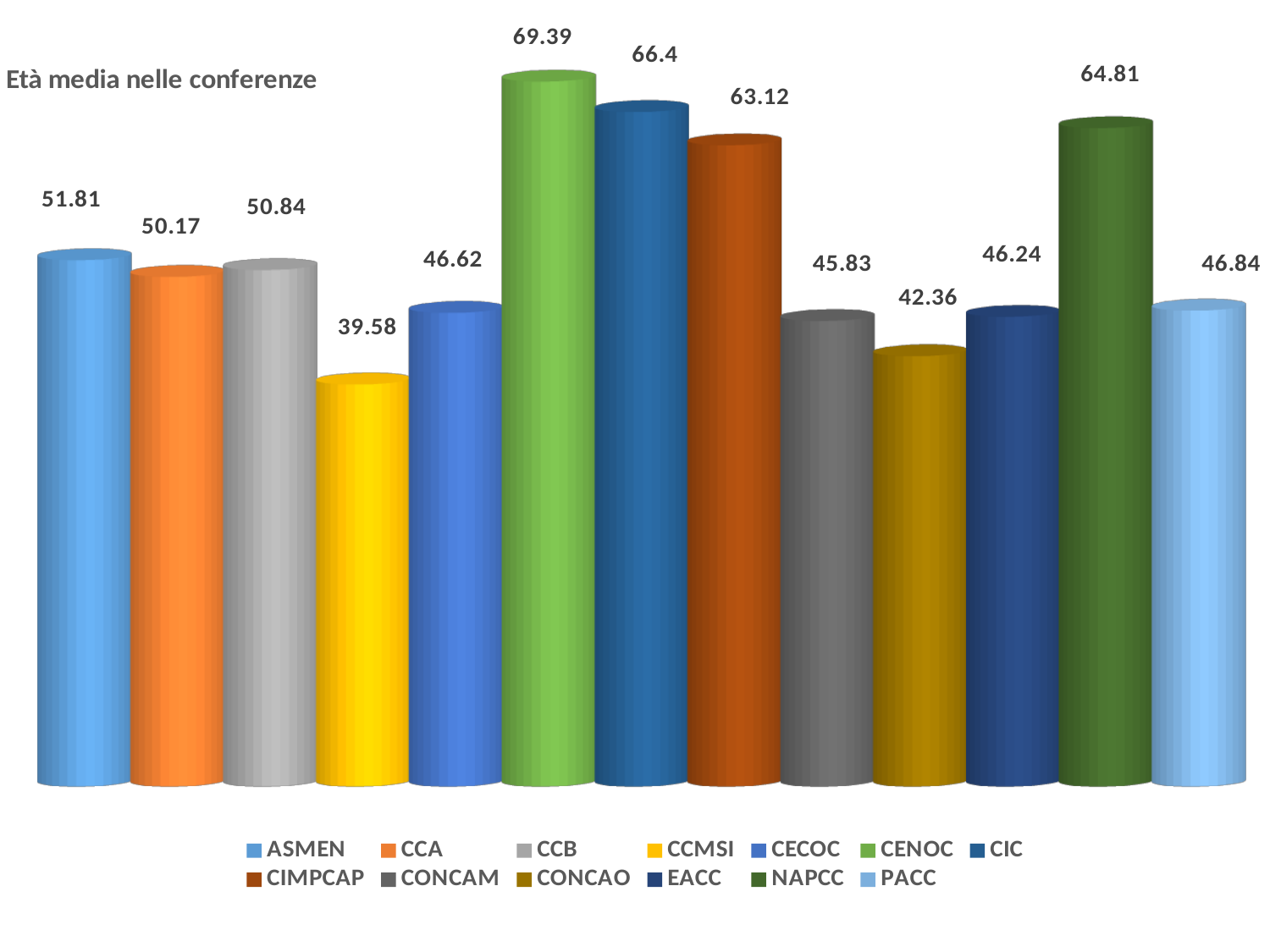
What is the difference between the values for CIC and CIMPCAP? 3.28 Which category has the lowest value? CCMSI What kind of chart is shown on the slide? Bar chart What is the value for CCMSI? 39.58 Which is larger, the value for CONCAO or the value for PACC? PACC What is the value for NAPCC? 64.81 Which category has the highest value? CENOC What is the value for CENOC? 69.39 How many entries does the legend list? 13 What is the title of the chart? Età media nelle conferenze How many categories are plotted in the chart? 13 Which is larger, the value for ASMEN or the value for CCB? ASMEN